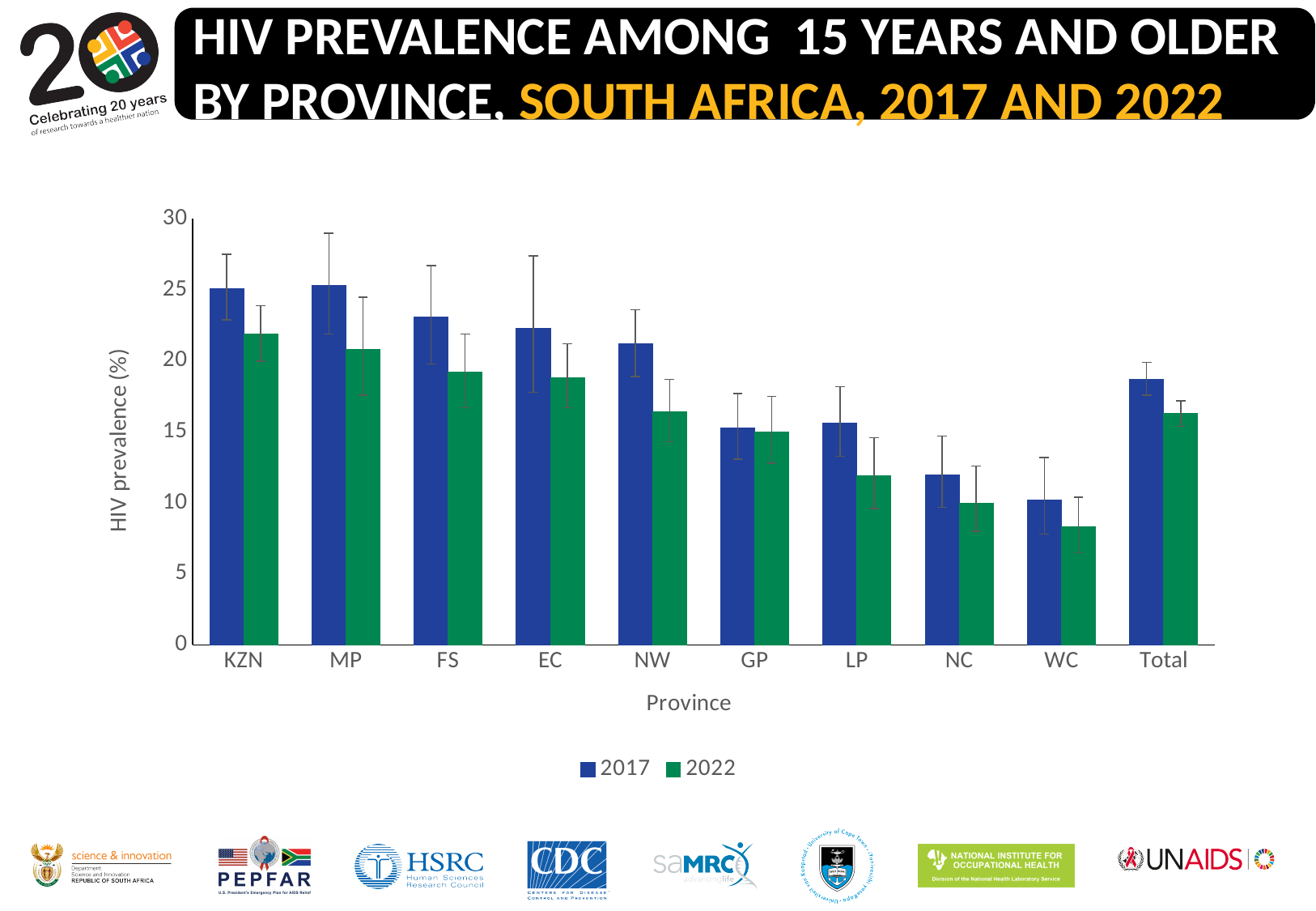
How many series does the legend list? 2 Is the 2022 value for NW greater or less than 15? greater What kind of chart is shown on the slide? bar chart Is the 2017 value for Total greater or less than 20? less Which province has the lowest HIV prevalence for 2017? WC Which is larger, the 2017 value for LP or the 2017 value for NC? LP Is the 2022 value for KZN greater or less than 20? greater Which province has the lowest HIV prevalence for 2022? WC For KZN, which is larger, the 2017 value or the 2022 value? 2017 What is the label of the y axis? HIV prevalence (%) How many categories are shown on the x axis? 10